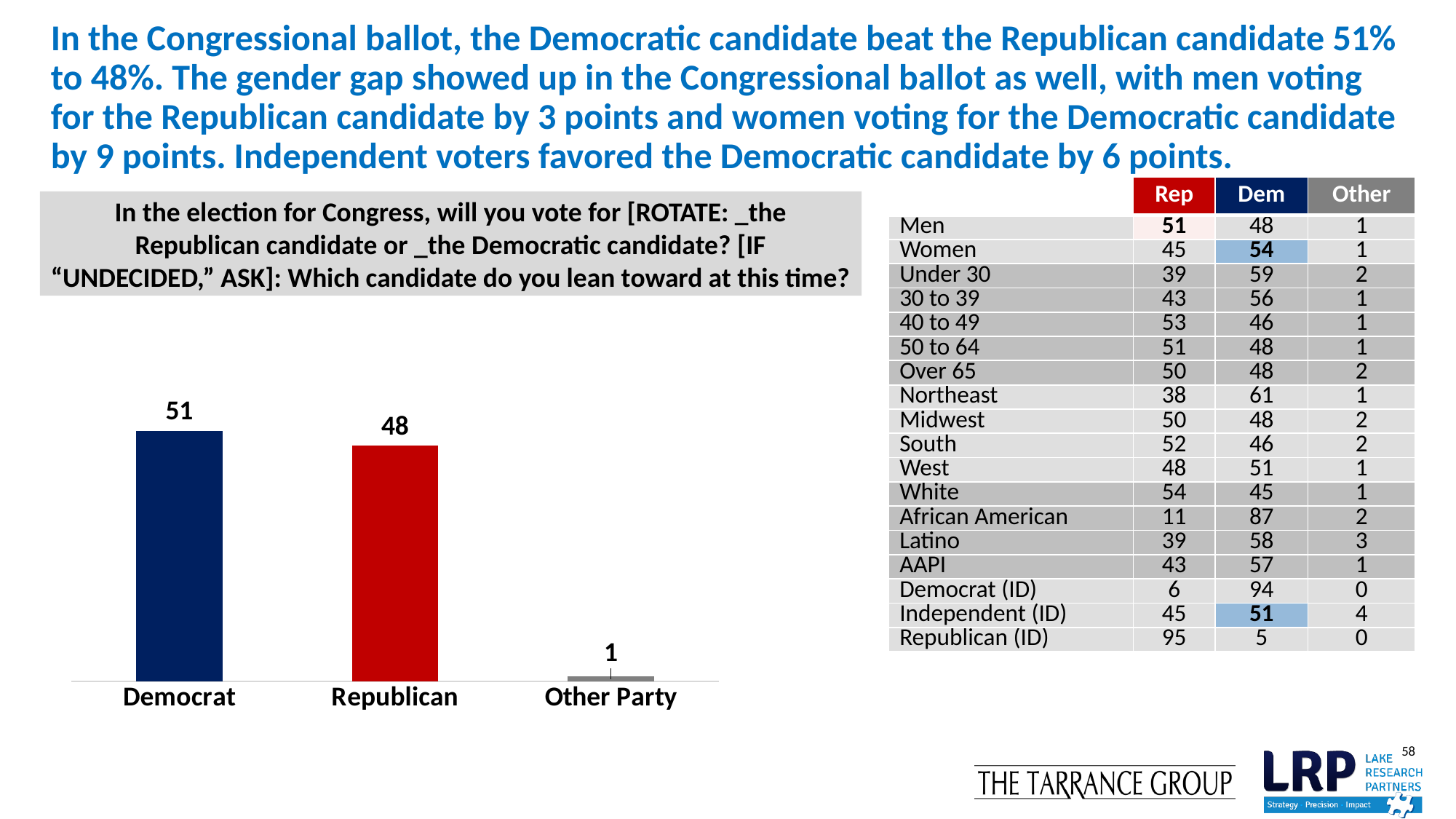
What is the value for Other Party in the bar chart? 1 What colour is the Republican bar in the bar chart? Red Which category has the highest value in the bar chart? Democrat What is the value for Democrat in the bar chart? 51 What colour is the Democrat bar in the bar chart? Dark blue Which is larger in the bar chart, the value for Republican or the value for Other Party? Republican How many categories are shown in the bar chart? 3 What is the value for Republican in the bar chart? 48 What kind of chart is shown on the slide? Bar chart Which category has the lowest value in the bar chart? Other Party What is the difference between the Democrat and Republican values in the bar chart? 3 Do the values in the bar chart rise or fall from left to right? Fall